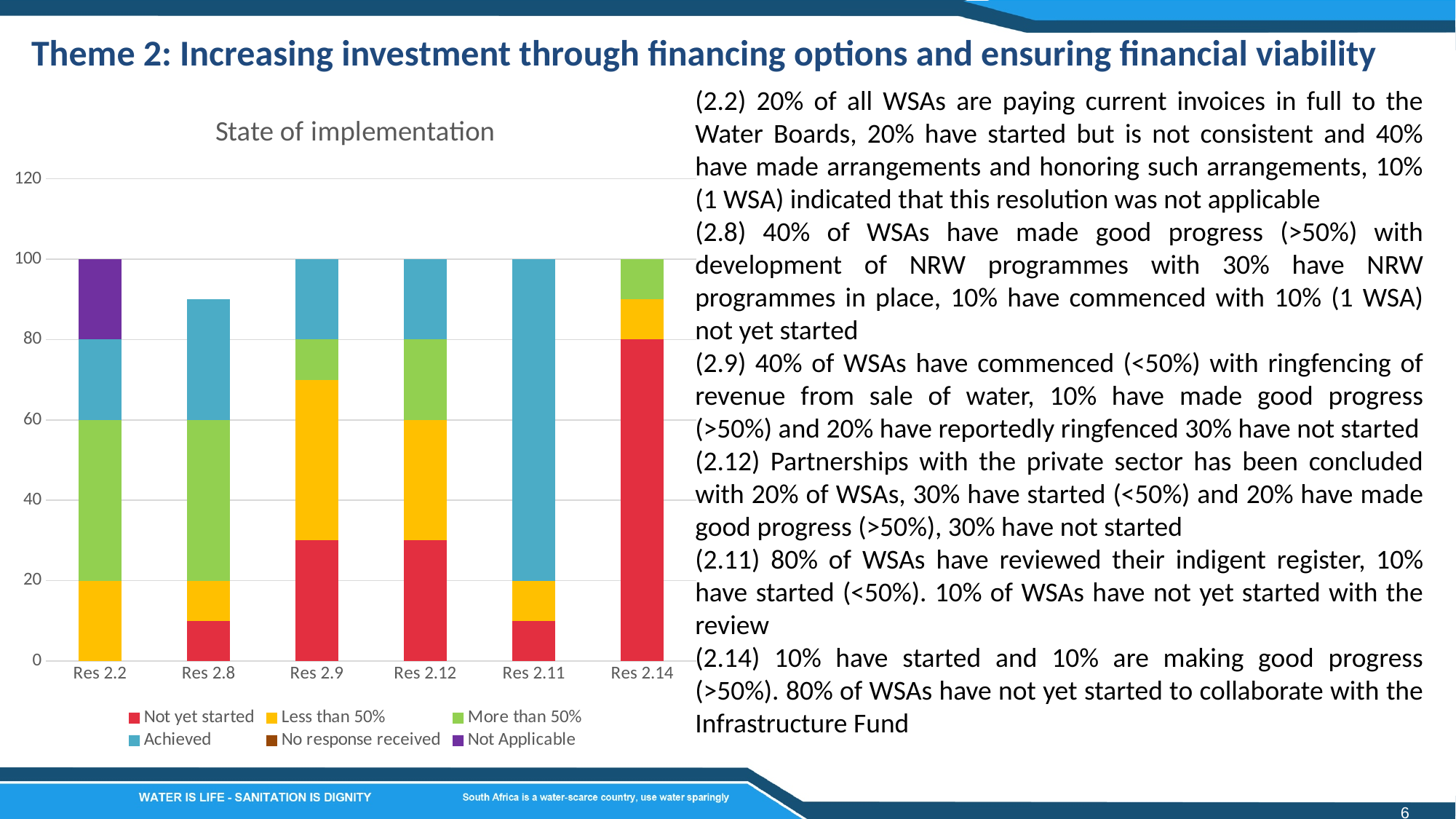
Which category has the largest 'Not yet started' segment? Res 2.14 Is the 'Not yet started' segment for Res 2.9 greater or less than 20? greater How many categories are shown on the x axis of the chart? 6 Which category is the only one with a 'Not Applicable' segment? Res 2.2 How many series does the chart legend list? 6 What is the total height of the stacked bar for Res 2.11? 100 What is the value of the 'Not yet started' segment for Res 2.14? 80 Is the total height of the stacked bar for Res 2.8 greater or less than 100? less What is the title of the chart? State of implementation What is the value of the 'Less than 50%' segment for Res 2.2? 20 What kind of chart is shown on the slide? Stacked bar chart Which category has the largest 'Achieved' segment? Res 2.11